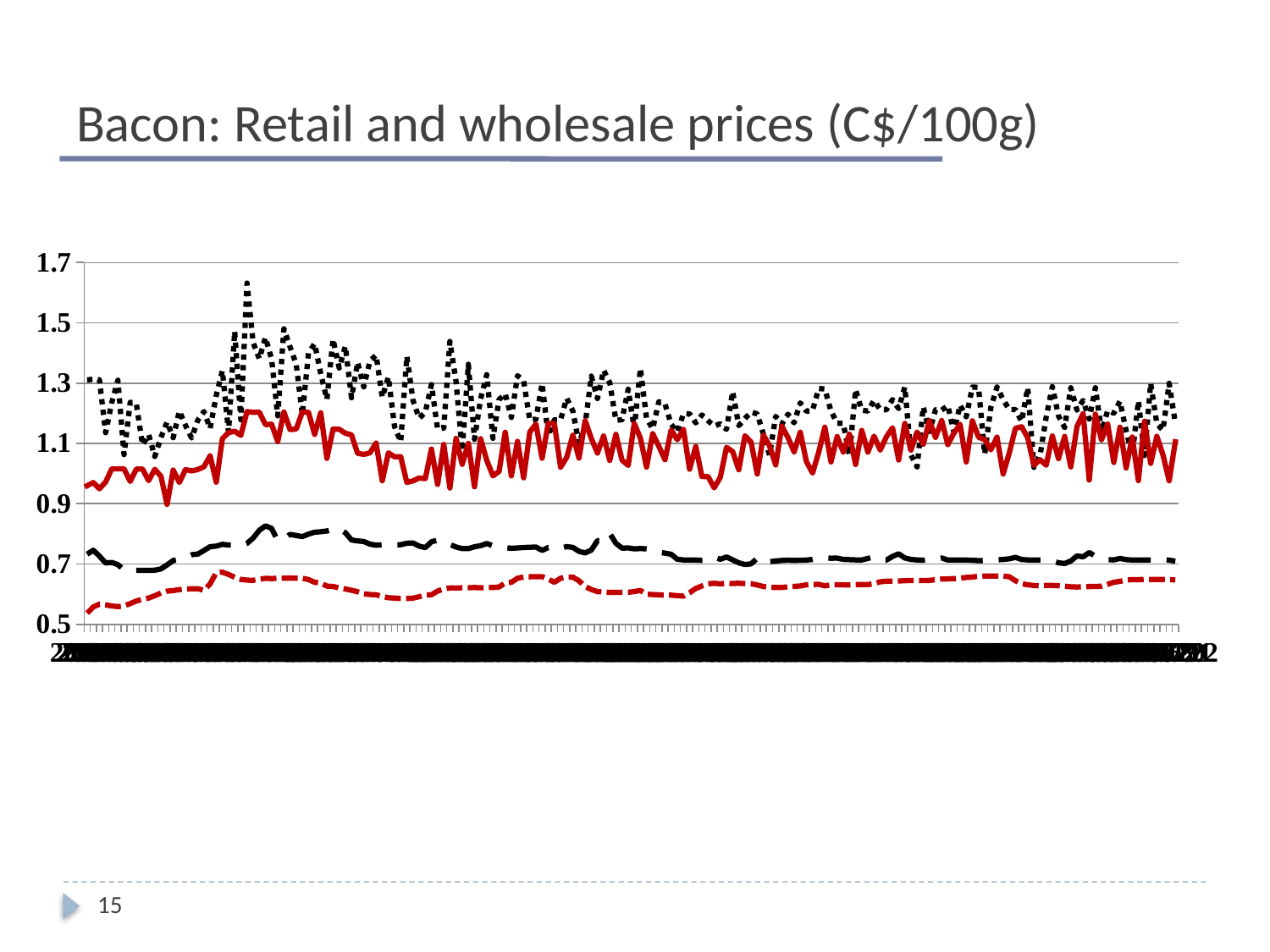
How many lines are plotted on the chart? 4 Which line stays lowest on the chart? the red dashed line Is the highest point of the lower red dashed line greater or less than 0.7? less In what units are the prices on the chart expressed? C$/100g Which is higher across the chart, the red solid line or the black dashed line? the red solid line Which line reaches the highest value on the chart? the black dotted line What is the title of the chart? Bacon: Retail and wholesale prices (C$/100g) Is the value of the red solid line at the right end of the chart greater or less than 0.9? greater Is the highest point of the black dashed line greater or less than 0.9? less What kind of chart is shown on the slide? line chart